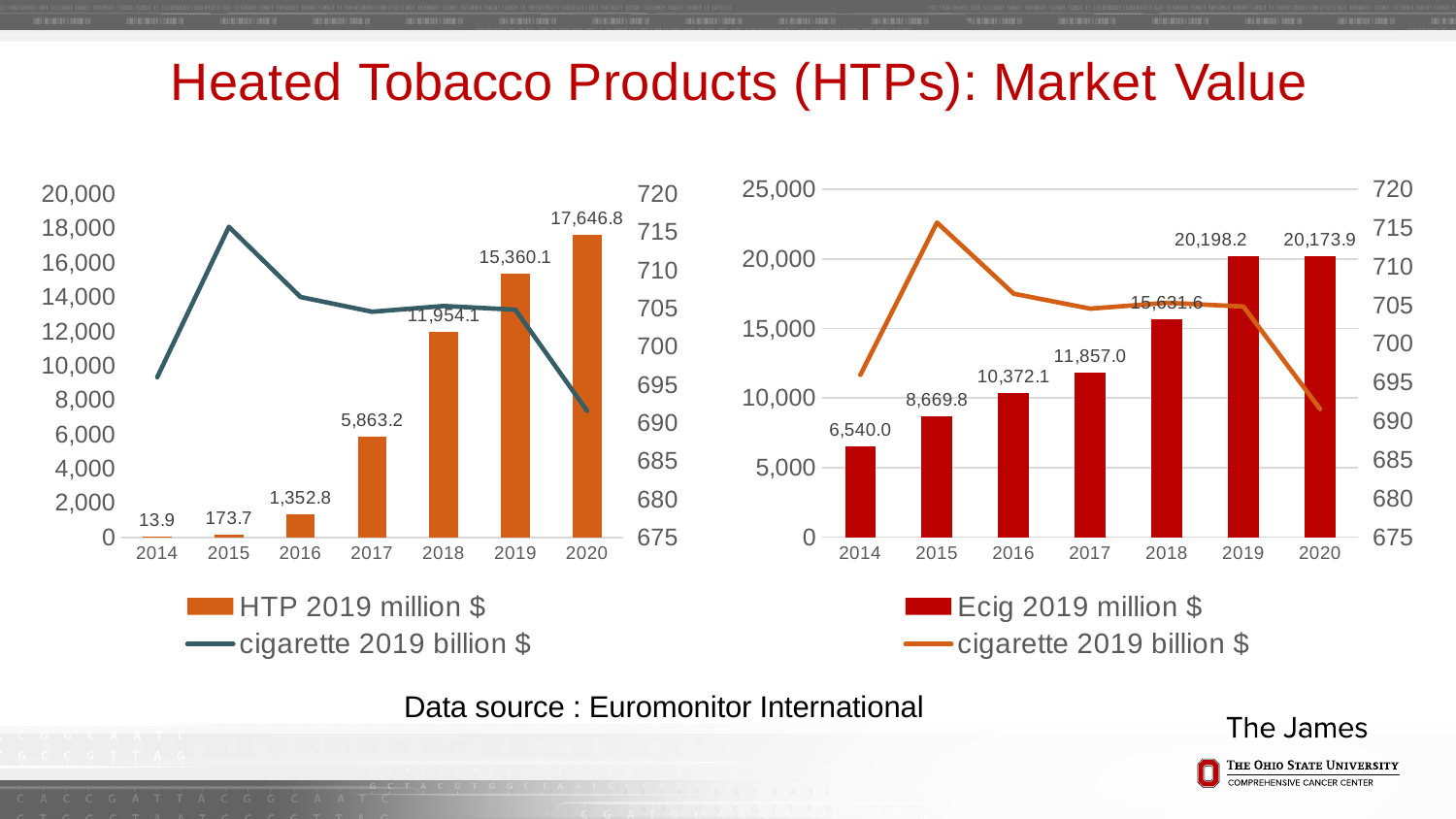
How many series does the legend of the right chart (Ecig) list? 2 How many years are shown on the x axis of the left chart (HTP)? 7 On the right chart (Ecig), is the cigarette value for 2020 greater or less than 695? less On the right chart (Ecig), which year has the highest Ecig market value? 2019 On the left chart (HTP), what is the HTP market value for 2020? 17,646.8 On the right chart (Ecig), which is larger, the Ecig value for 2017 or for 2016? 2017 On the left chart (HTP), what is the HTP market value for 2014? 13.9 On the left chart (HTP), what is the difference between the HTP values for 2020 and 2019? 2,286.7 On the right chart (Ecig), what is the Ecig market value for 2018? 15,631.6 On the right chart (Ecig), what is the difference between the Ecig values for 2015 and 2014? 2,129.8 On the left chart (HTP), which year has the lowest HTP market value? 2014